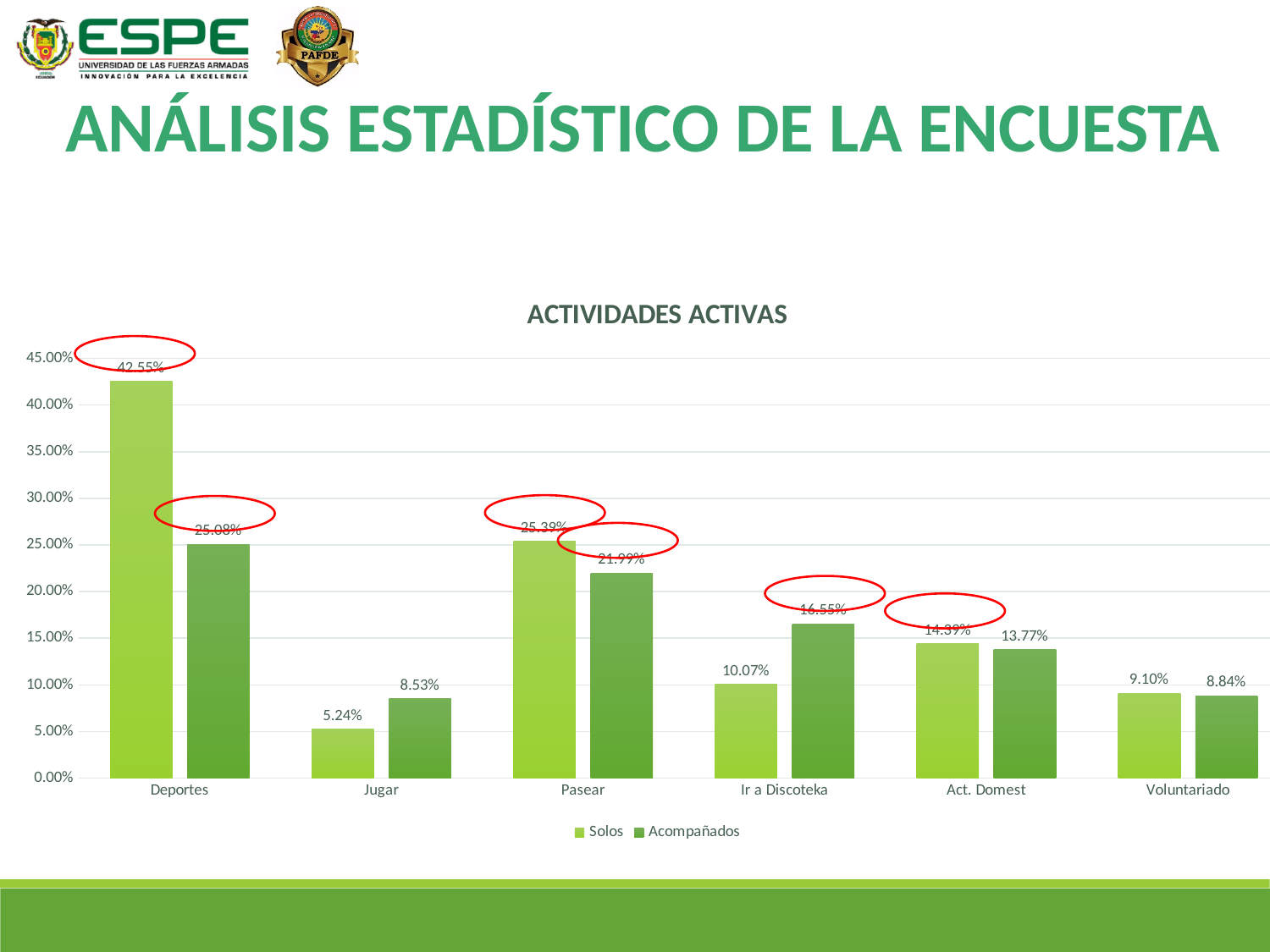
Is the Acompañados value for Pasear greater or less than 20.00%? greater What is the Solos value for Ir a Discoteka? 10.07% What is the Solos value for Deportes? 42.55% Which category has the lowest Acompañados value? Jugar Which category has the highest Solos value? Deportes How many categories are shown on the x axis? 6 What is the Acompañados value for Act. Domest? 13.77% How many series does the legend list? 2 For Ir a Discoteka, which is larger: the Solos value or the Acompañados value? Acompañados What type of chart is shown? Bar chart What is the difference between the Acompañados and Solos values for Jugar? 3.29% What is the Acompañados value for Jugar? 8.53%